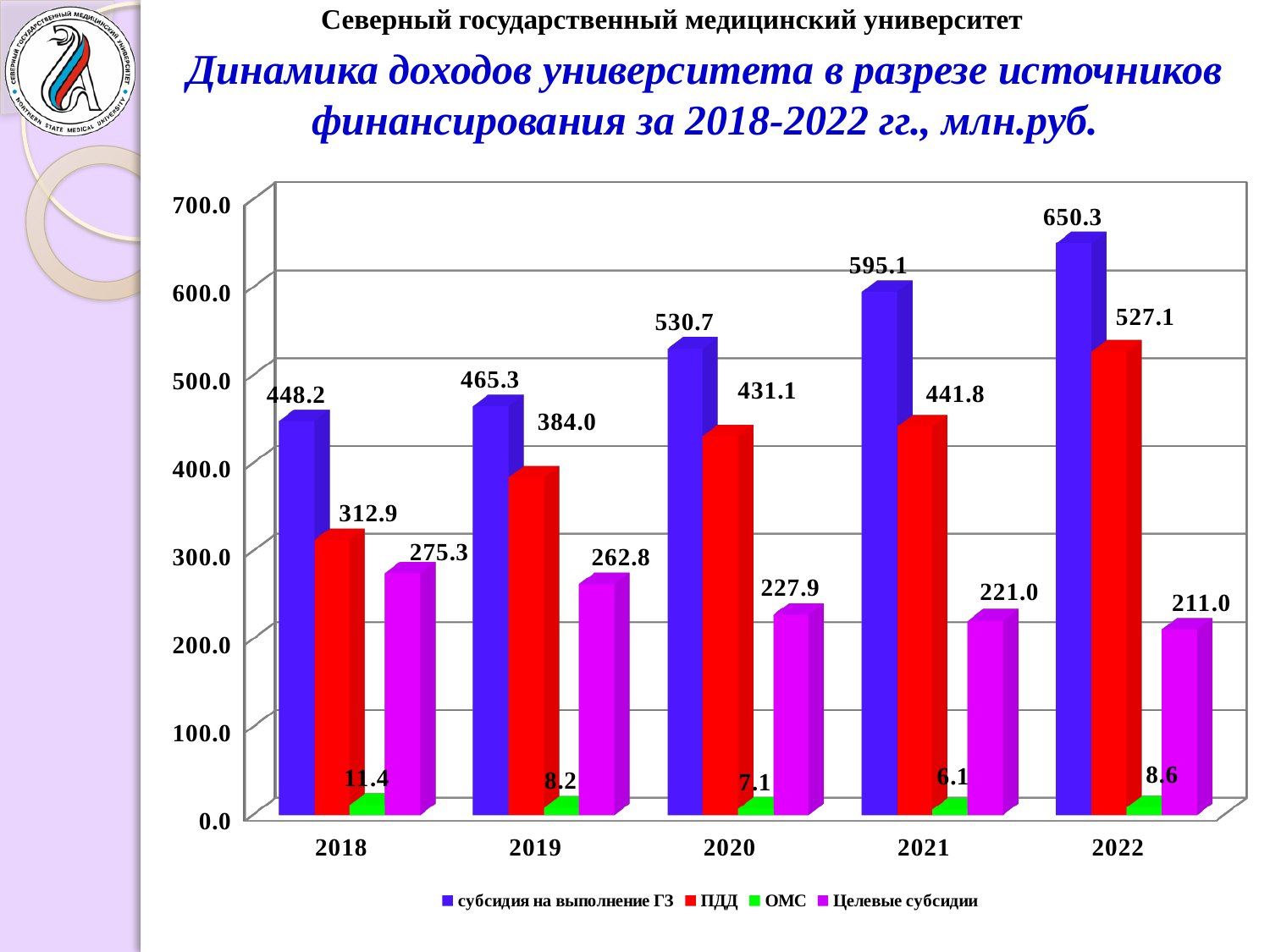
What is the value of ПДД in 2019? 384.0 In which year is субсидия на выполнение ГЗ the highest? 2022 What is the value of ОМС in 2020? 7.1 What is the value of Целевые субсидии in 2018? 275.3 What is the difference between ПДД in 2022 and in 2021? 85.3 In which year is ОМС the lowest? 2021 Do the values of Целевые субсидии rise or fall from 2018 to 2022? fall What is the difference between субсидия на выполнение ГЗ in 2022 and in 2018? 202.1 What is the value of субсидия на выполнение ГЗ in 2022? 650.3 How many years are shown on the x axis? 5 Which is larger: Целевые субсидии in 2019 or ПДД in 2018? ПДД in 2018 How many series does the legend list? 4